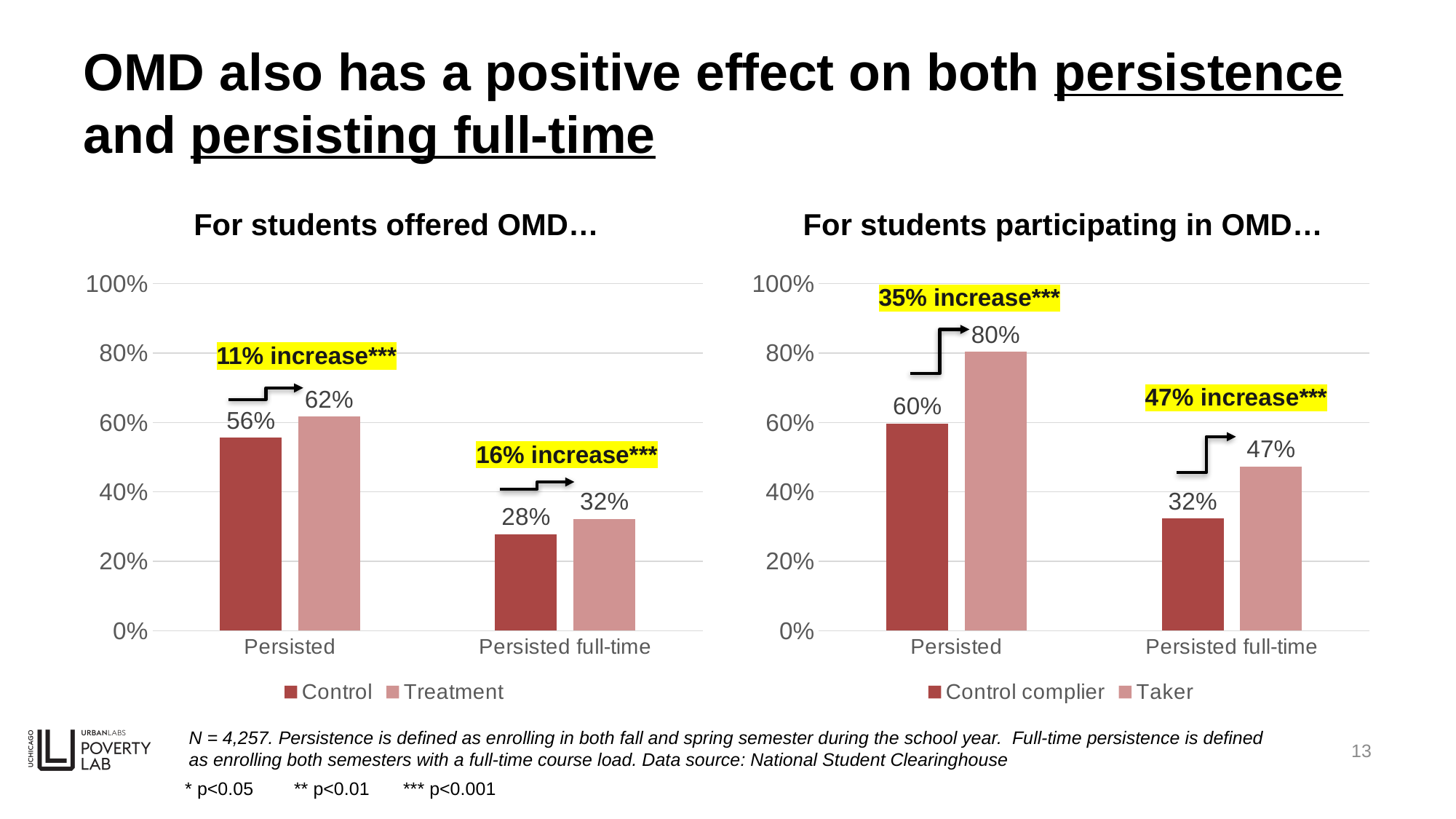
In the 'For students offered OMD…' chart, which category has the lowest Control value? Persisted full-time In the 'For students participating in OMD…' chart, what is the difference between the Taker and Control complier values for Persisted? 20% In the 'For students participating in OMD…' chart, what is the Taker value for Persisted? 80% How many series does the legend of the 'For students offered OMD…' chart list? 2 In the 'For students participating in OMD…' chart, which is larger for Persisted full-time: Control complier or Taker? Taker In the 'For students participating in OMD…' chart, what is the Control complier value for Persisted full-time? 32% In the 'For students offered OMD…' chart, what is the difference between the Treatment and Control values for Persisted? 6% In the 'For students participating in OMD…' chart, is the Control complier value for Persisted greater or less than 40%? greater In the 'For students participating in OMD…' chart, what percentage increase is annotated for Persisted full-time? 47% increase*** In the 'For students offered OMD…' chart, what is the Control value for Persisted? 56% What kind of chart is the 'For students participating in OMD…' chart? Bar chart In the 'For students offered OMD…' chart, what is the Treatment value for Persisted full-time? 32%